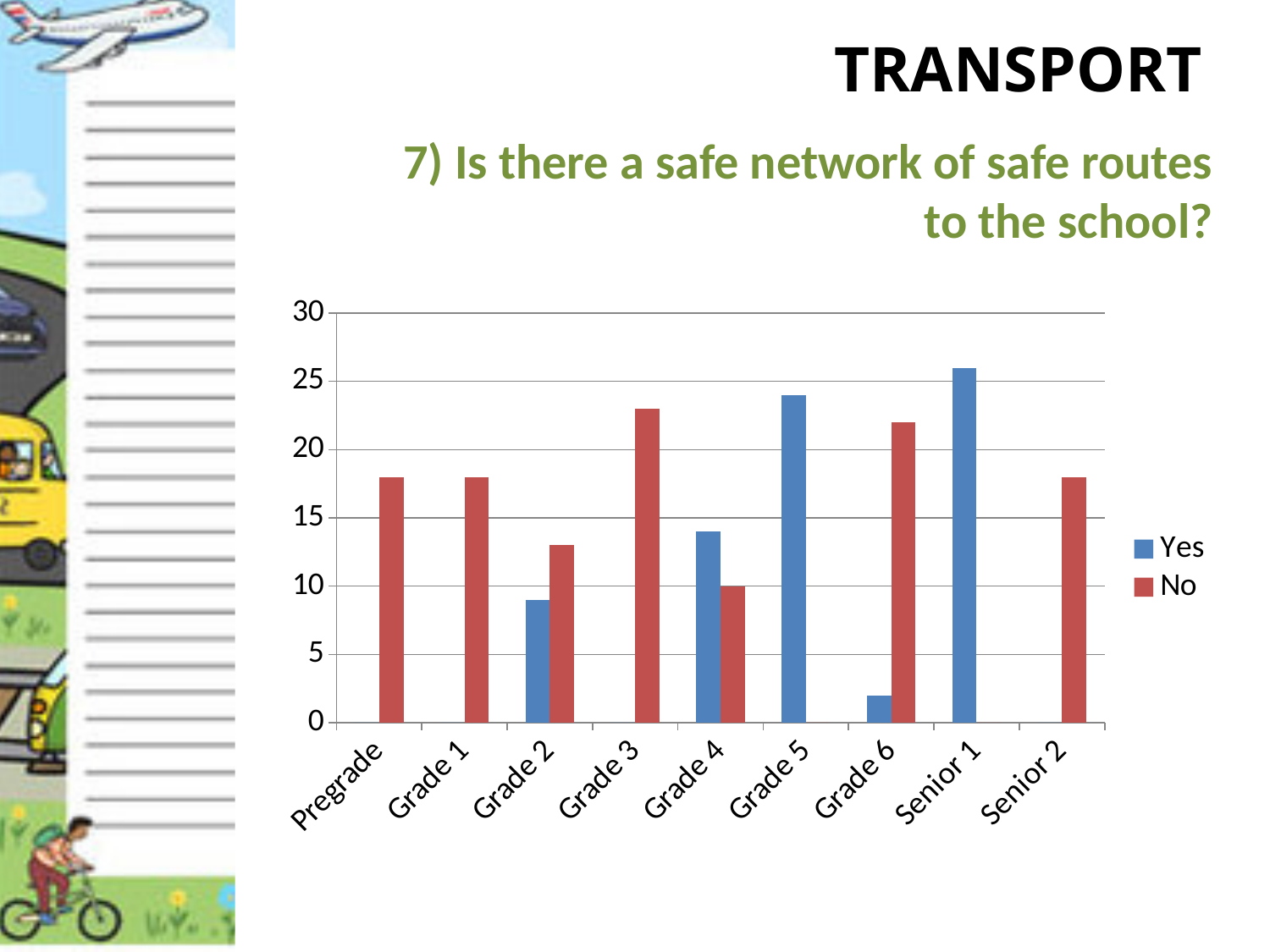
What colour are the No bars? red Which category has the lowest Yes value among those with a Yes bar? Grade 6 How many categories are shown on the x axis? 9 Which category has the highest Yes value? Senior 1 Is the No value for Grade 2 greater or less than 15? less For Grade 4, which is larger, the Yes value or the No value? Yes Is the Yes value for Grade 5 greater or less than 20? greater Which category has the highest No value? Grade 3 What kind of chart is shown on the slide? bar chart Is the Yes value for Senior 1 greater or less than 25? greater How many series does the legend list? 2 For Grade 6, which is larger, the Yes value or the No value? No